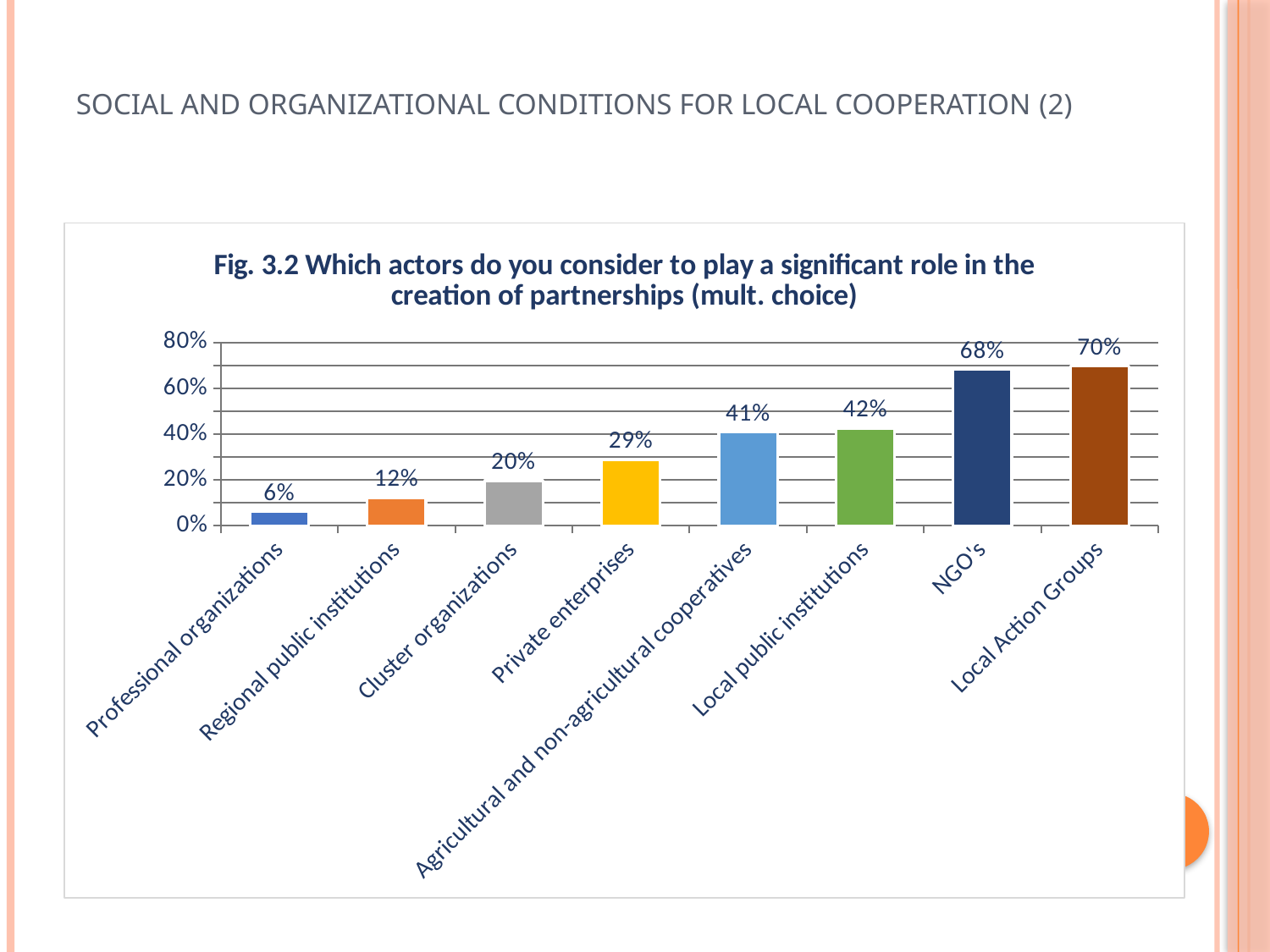
What is the difference between the values for Local public institutions and Regional public institutions? 30% Do the values rise or fall from left to right across the categories? Rise What is the value shown for Private enterprises? 29% Which actor has the highest value in the chart? Local Action Groups What percentage of respondents consider NGO's to play a significant role in the creation of partnerships? 68% What is the figure number given in the chart title? Fig. 3.2 Which actor has the lowest value in the chart? Professional organizations What kind of chart is shown on the slide? Bar chart Which is larger, the value for Cluster organizations or the value for Private enterprises? Private enterprises What is the value shown for Professional organizations? 6% What is the difference between the values for Local Action Groups and NGO's? 2% How many actor categories are shown in the chart? 8